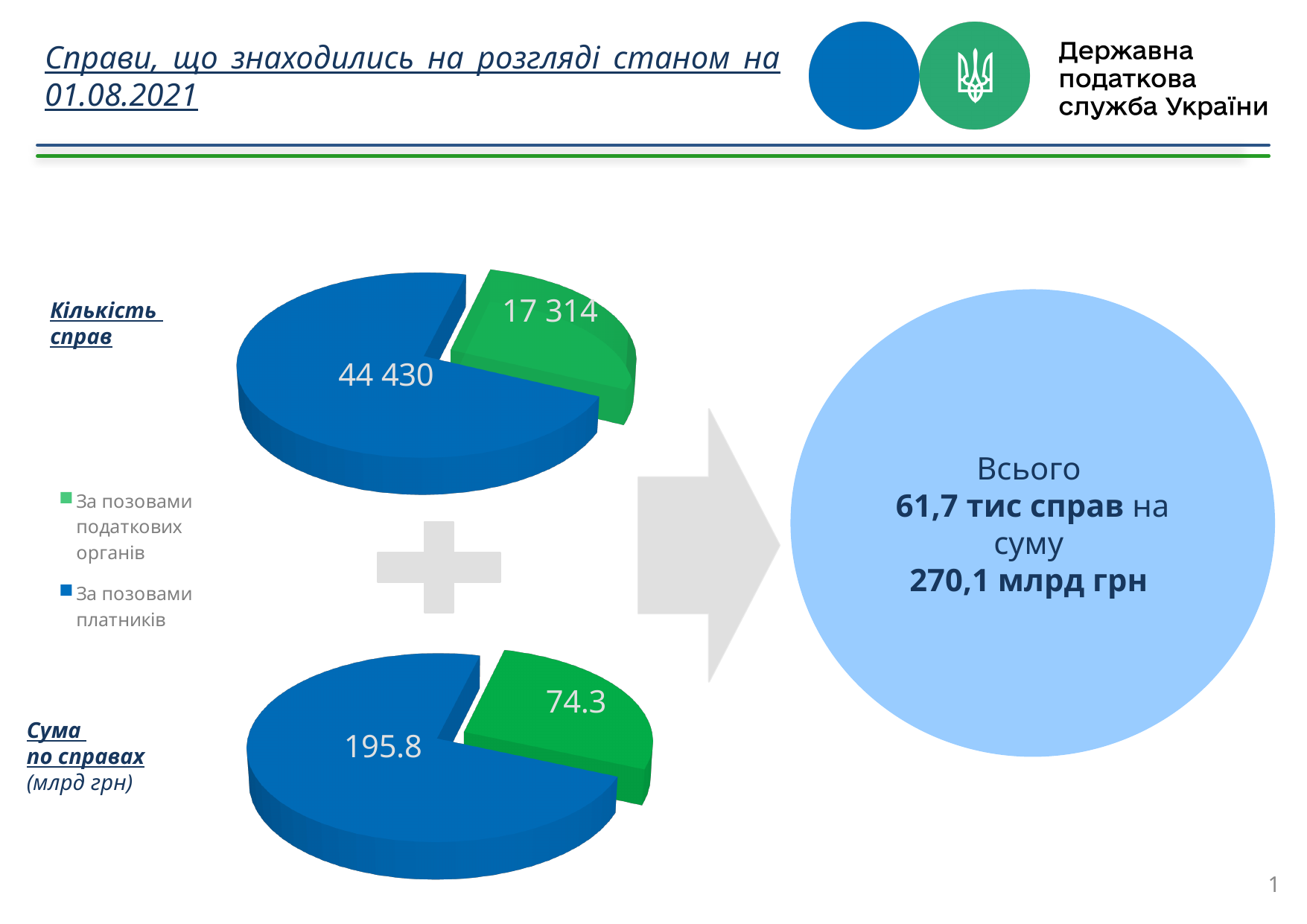
In the bottom pie chart (Сума по справах, млрд грн), which category has the smallest slice? За позовами податкових органів What type of chart is used for Кількість справ on the slide? Pie chart Which colour represents За позовами податкових органів in the pie charts? Green In the top pie chart (Кількість справ), what is the difference between the value for За позовами платників and the value for За позовами податкових органів? 27 116 In the bottom pie chart (Сума по справах, млрд грн), what is the value for За позовами податкових органів? 74.3 In the bottom pie chart (Сума по справах, млрд грн), which is larger: the value for За позовами платників or the value for За позовами податкових органів? За позовами платників In the top pie chart (Кількість справ), which category has the largest slice? За позовами платників In the bottom pie chart (Сума по справах, млрд грн), what is the value for За позовами платників? 195.8 In the bottom pie chart (Сума по справах, млрд грн), what is the difference between the value for За позовами платників and the value for За позовами податкових органів? 121.5 How many slices does the top pie chart (Кількість справ) have? 2 In the top pie chart (Кількість справ), what is the value for За позовами платників? 44 430 In the top pie chart (Кількість справ), what is the value for За позовами податкових органів? 17 314